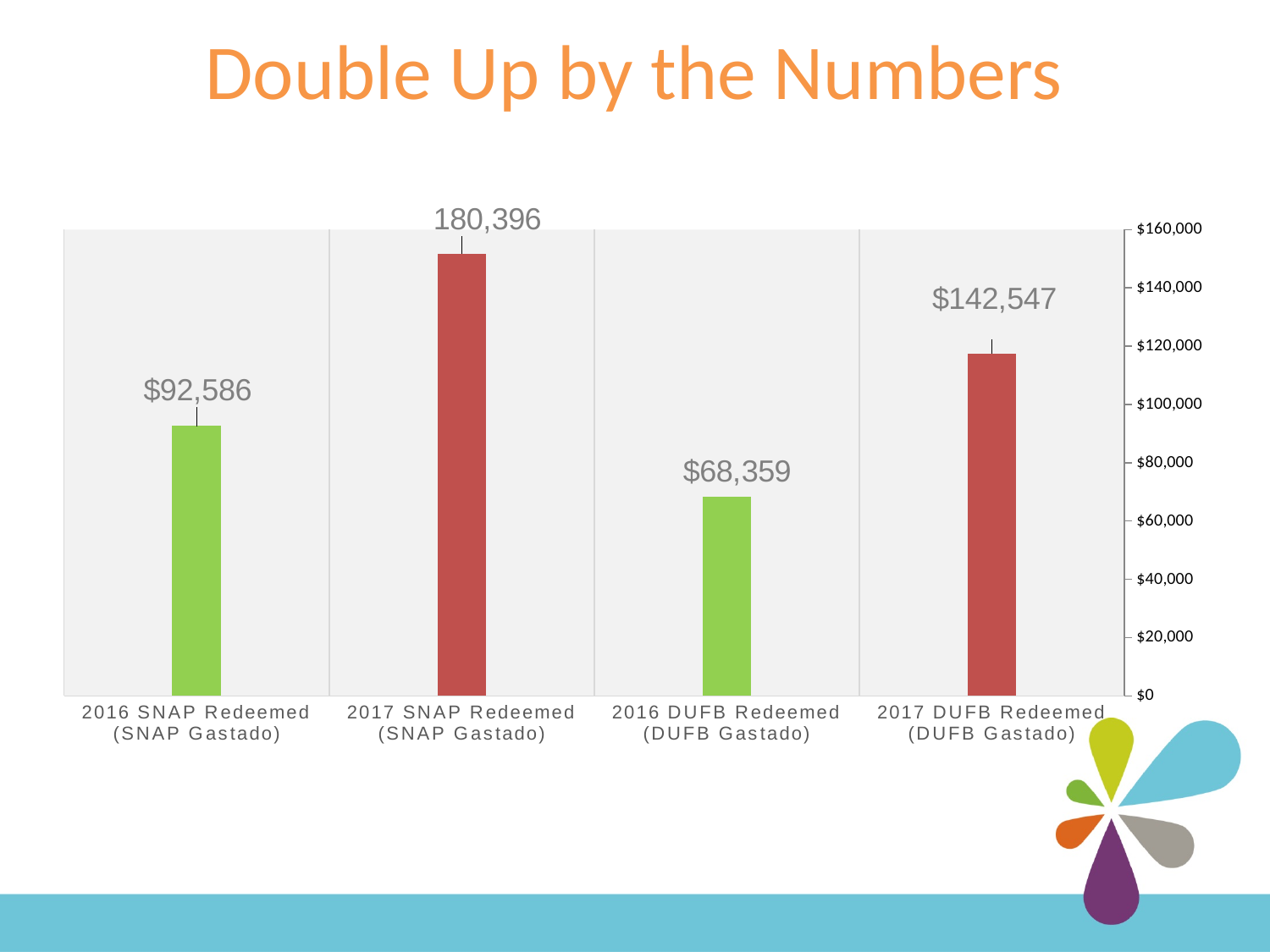
How many categories are shown on the x axis? 4 What is the value for 2017 SNAP Redeemed (SNAP Gastado)? 180,396 What is the value for 2016 DUFB Redeemed (DUFB Gastado)? $68,359 Which category has the highest value? 2017 SNAP Redeemed (SNAP Gastado) What is the difference between the 2017 SNAP Redeemed value and the 2016 SNAP Redeemed value? $87,810 What is the difference between the 2017 DUFB Redeemed value and the 2016 DUFB Redeemed value? $74,188 What kind of chart is shown on the slide? Bar chart Which is larger, the value for 2016 SNAP Redeemed or the value for 2016 DUFB Redeemed? 2016 SNAP Redeemed What is the title of the slide? Double Up by the Numbers What is the value for 2017 DUFB Redeemed (DUFB Gastado)? $142,547 What is the value for 2016 SNAP Redeemed (SNAP Gastado)? $92,586 Which category has the lowest value? 2016 DUFB Redeemed (DUFB Gastado)